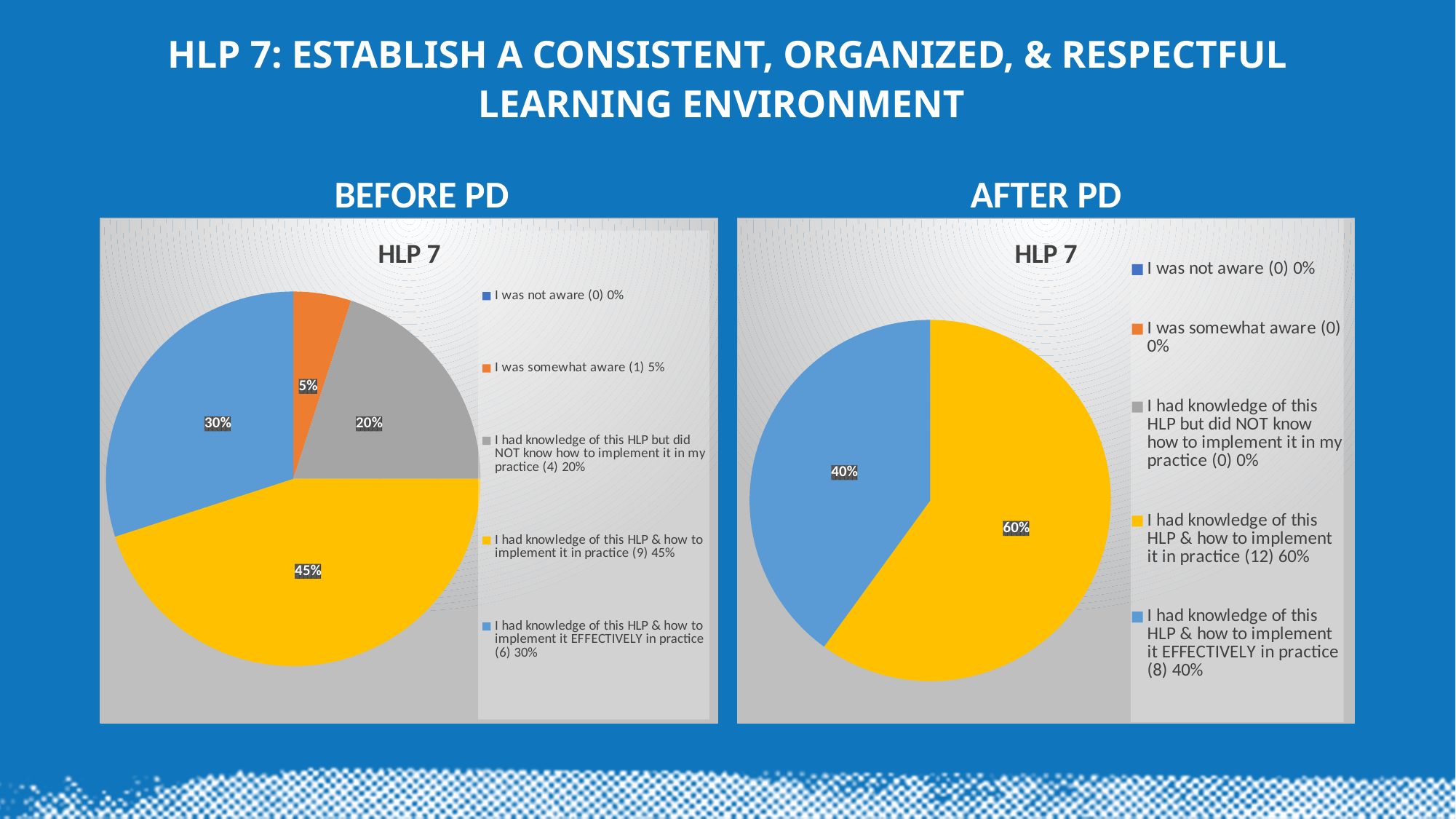
In the BEFORE PD chart, which is larger: the share for 'I had knowledge of this HLP but did NOT know how to implement it in my practice' or the share for 'I had knowledge of this HLP & how to implement it EFFECTIVELY in practice'? I had knowledge of this HLP & how to implement it EFFECTIVELY in practice In the BEFORE PD chart, what is the difference between the 45% slice and the 30% slice? 15% In the BEFORE PD chart, what share of respondents said they had knowledge of this HLP & how to implement it in practice? 45% What is the title shown inside both charts? HLP 7 What kind of chart is the BEFORE PD chart? Pie chart In the AFTER PD chart, what is the difference between the 60% slice and the 40% slice? 20% In the AFTER PD chart, what share of respondents said they had knowledge of this HLP & how to implement it EFFECTIVELY in practice? 40% In the BEFORE PD chart, what percentage is shown for 'I was somewhat aware'? 5% How many entries does the legend list in the AFTER PD chart? 5 In the BEFORE PD chart, which category has the largest slice? I had knowledge of this HLP & how to implement it in practice In the AFTER PD chart, how many respondents said they had knowledge of this HLP & how to implement it in practice? 12 In the AFTER PD chart, which category has the largest slice? I had knowledge of this HLP & how to implement it in practice